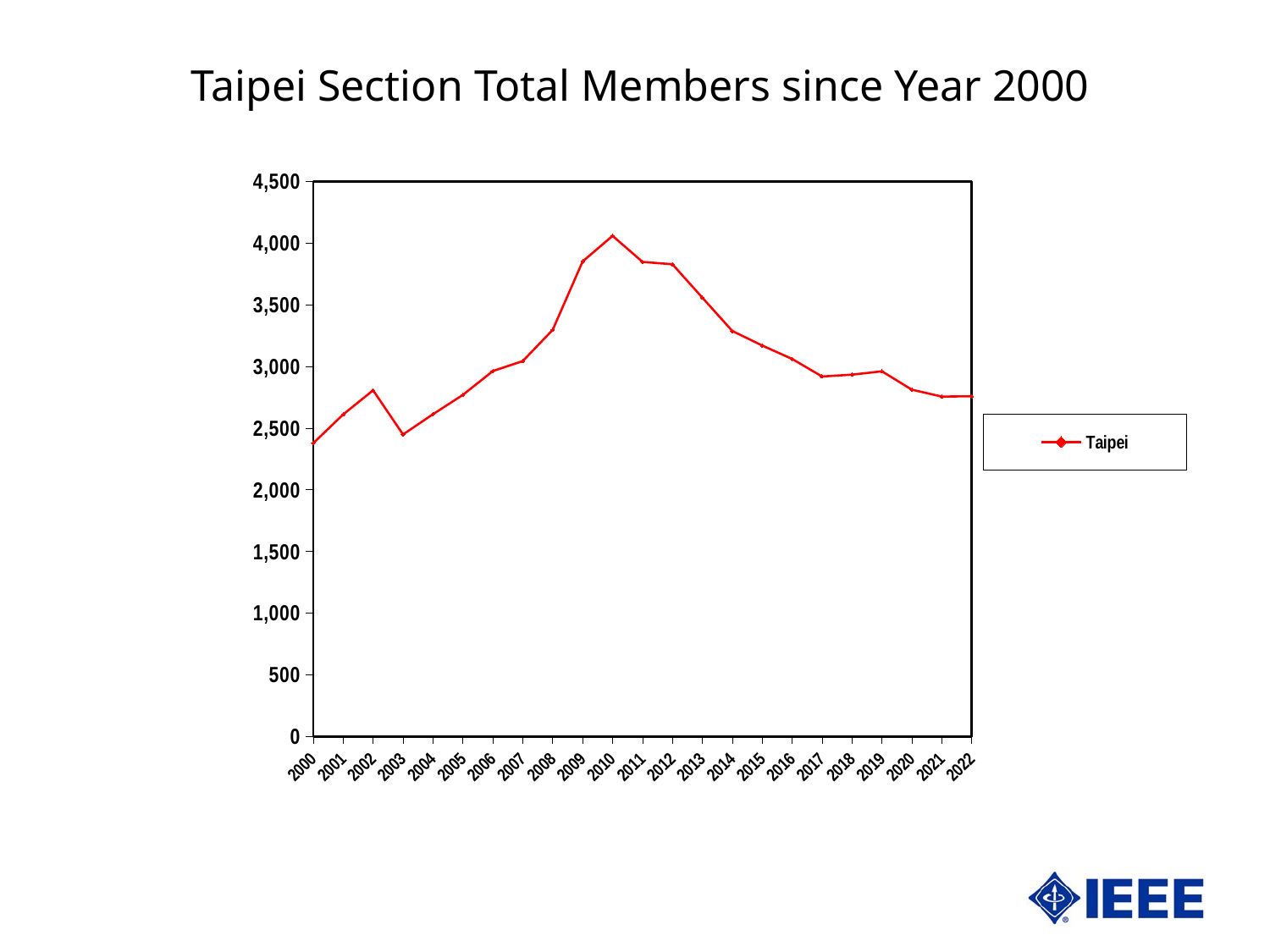
In which year is the number of Taipei members lowest? 2000 Do the values rise or fall from 2010 to 2022? fall How many series does the legend list? 1 Is the value for 2014 greater or less than 3,000? greater What is the title of the chart? Taipei Section Total Members since Year 2000 Is the value for 2000 greater or less than 2,500? less How many years are plotted along the x axis? 23 What kind of chart is shown on the slide? line chart In which year is the number of Taipei members highest? 2010 Which year has more members, 2002 or 2003? 2002 What is the name of the series shown in the legend? Taipei Is the value for 2010 greater or less than 4,000? greater